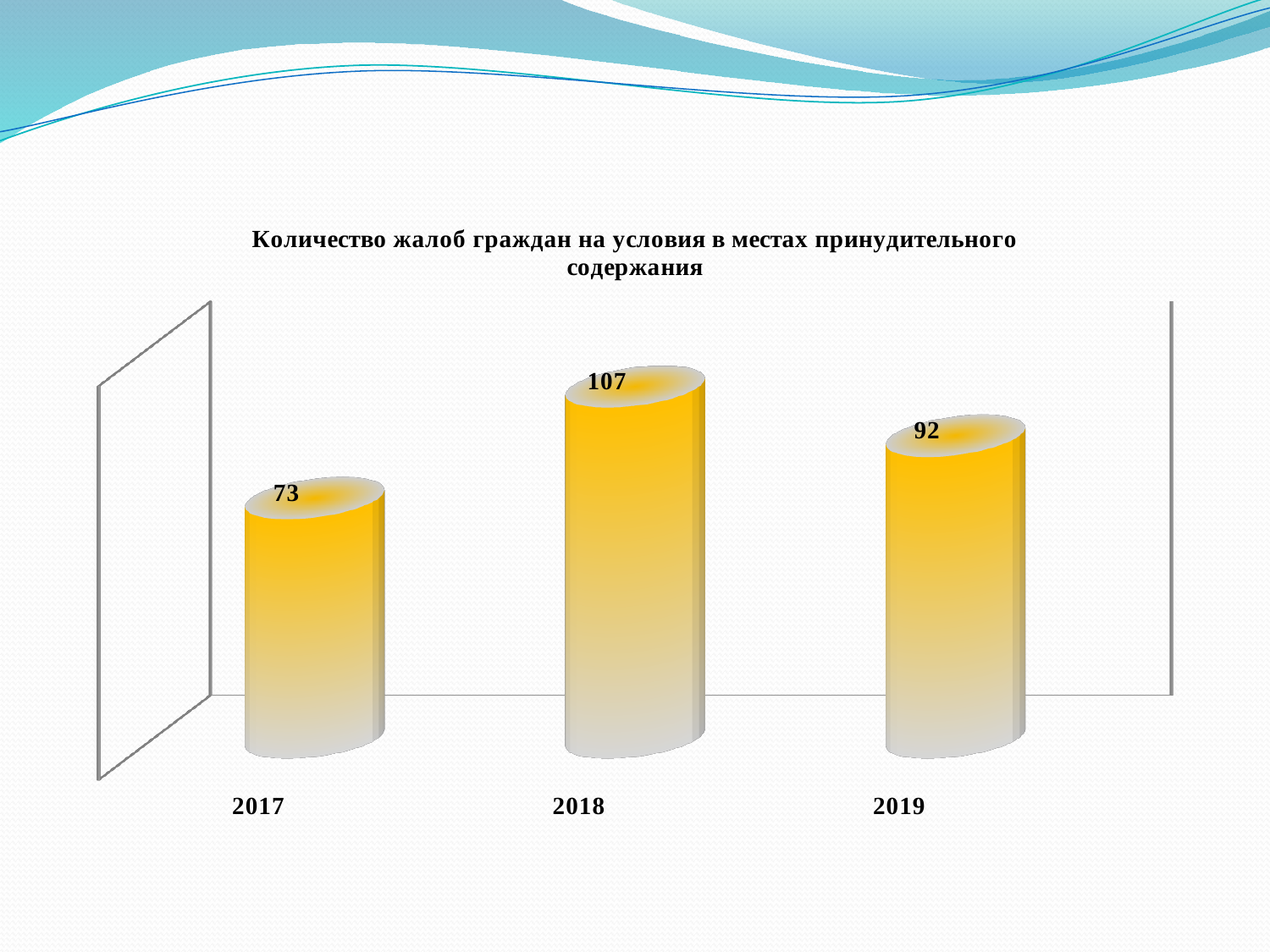
What is the value for 2019? 92 What is the difference between the values for 2018 and 2019? 15 What is the title of the chart? Количество жалоб граждан на условия в местах принудительного содержания What kind of chart is shown on the slide? bar chart What is the difference between the values for 2018 and 2017? 34 What is the value for 2018? 107 What is the value for 2017? 73 Does the value rise or fall from 2018 to 2019? fall How many years are shown on the chart? 3 Which year has the highest value? 2018 Which year has the lowest value? 2017 Which is larger, the value for 2019 or the value for 2017? 2019